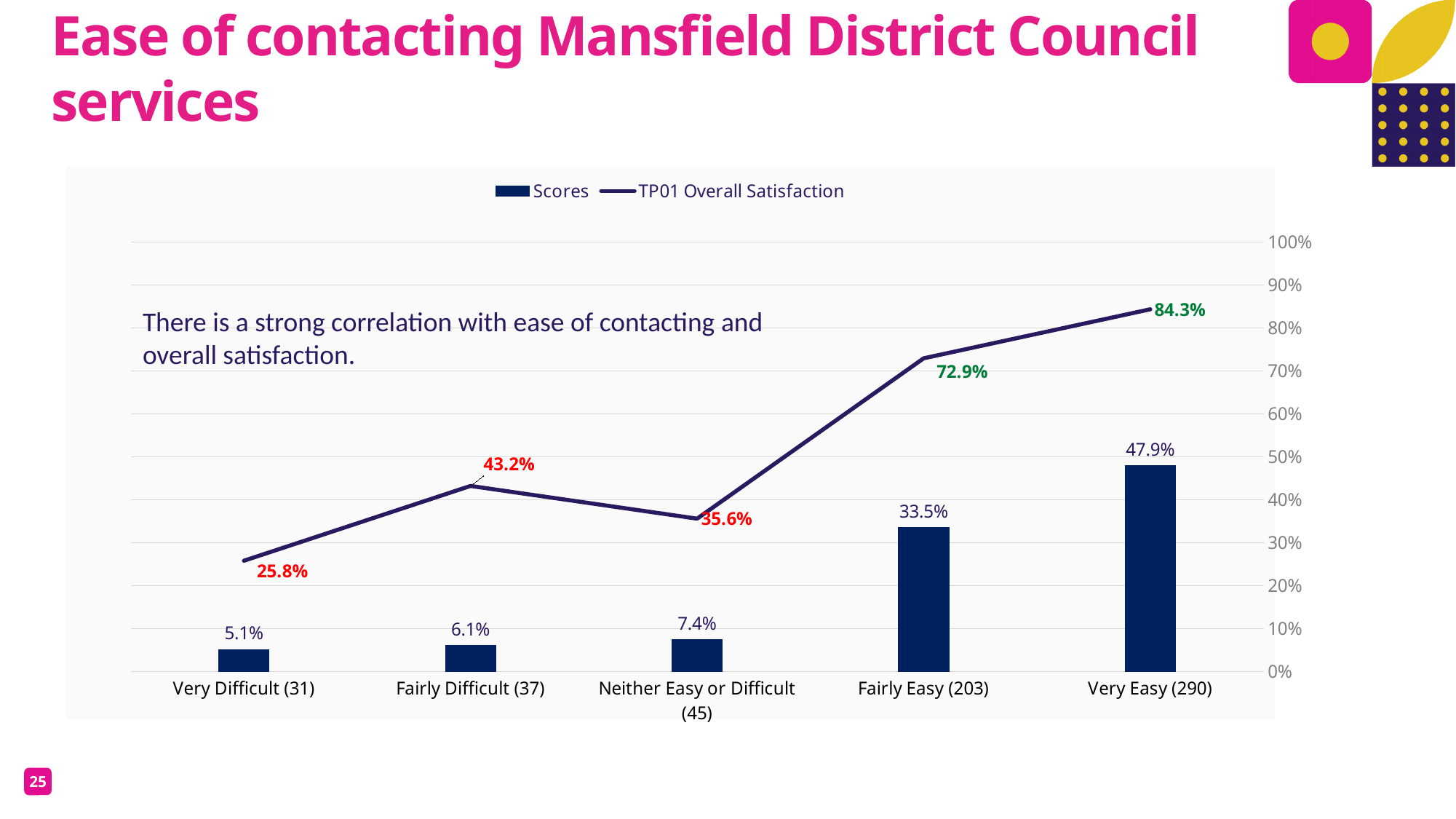
What is the Scores value for Neither Easy or Difficult (45)? 7.4% What are the two series named in the legend? Scores and TP01 Overall Satisfaction What is the difference between the Scores values for Very Easy (290) and Fairly Easy (203)? 14.4% What is the Scores value for Very Easy (290)? 47.9% Does the TP01 Overall Satisfaction line rise or fall between Neither Easy or Difficult (45) and Very Easy (290)? rise Which category has the highest Scores value? Very Easy (290) How many series does the legend list? 2 What is the TP01 Overall Satisfaction value for Fairly Difficult (37)? 43.2% How many categories are shown on the x axis? 5 Which is larger, the TP01 Overall Satisfaction value for Fairly Difficult (37) or for Neither Easy or Difficult (45)? Fairly Difficult (37) What is the TP01 Overall Satisfaction value for Very Easy (290)? 84.3% Which category has the lowest TP01 Overall Satisfaction value? Very Difficult (31)